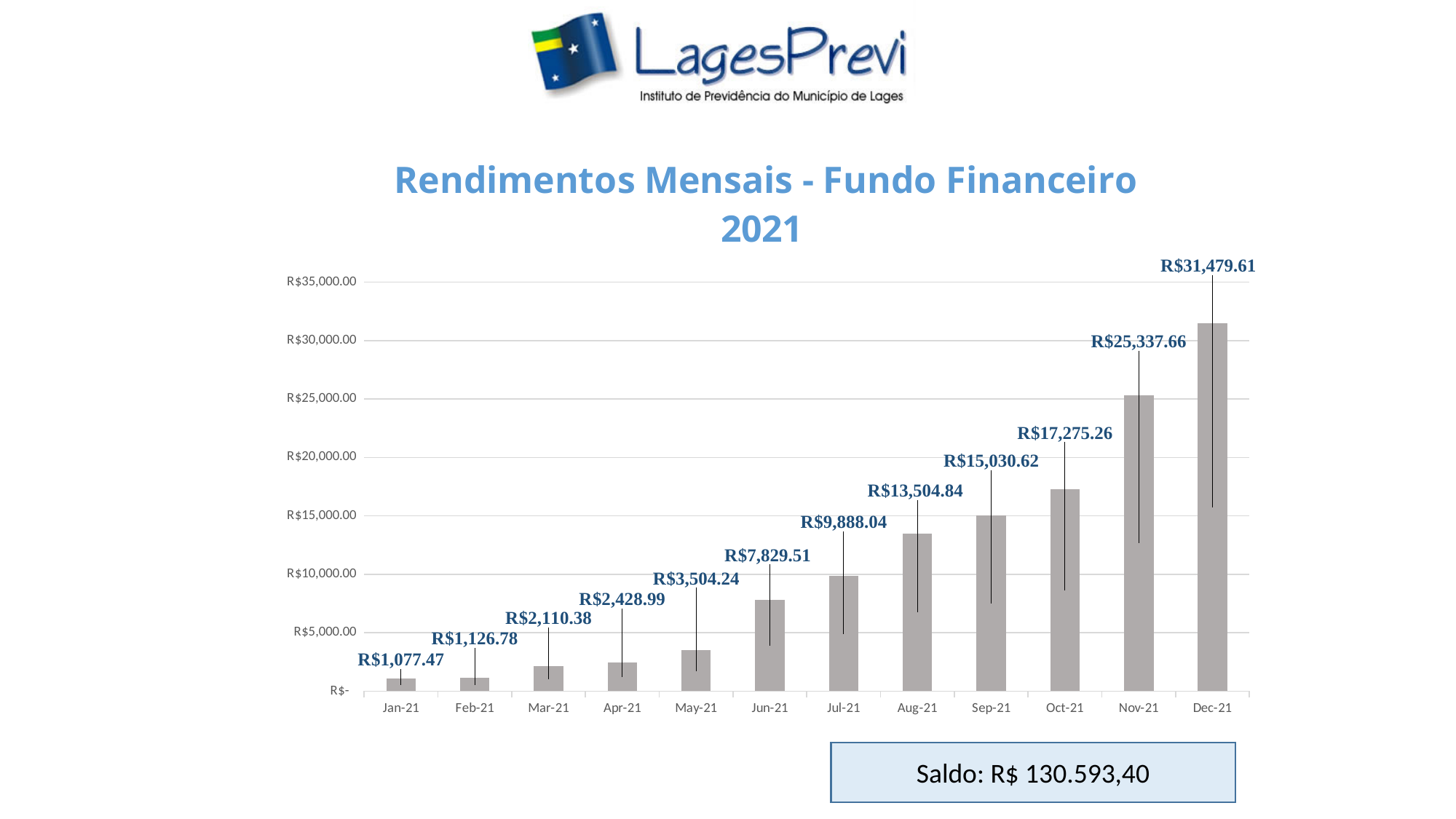
Which month has the lowest value? Jan-21 Which month has the highest value? Dec-21 What is the difference between the values for Dec-21 and Nov-21? R$6,141.95 What is the value for Jun-21? R$7,829.51 What type of chart is shown on the slide? Bar chart Is the value for Oct-21 greater or less than R$20,000.00? less What is the difference between the values for Oct-21 and Sep-21? R$2,244.64 What is the value for Mar-21? R$2,110.38 Do the values rise or fall from Jan-21 to Dec-21? Rise Which is larger, the value for Jul-21 or the value for Aug-21? Aug-21 What is the value for Sep-21? R$15,030.62 How many months are plotted on the chart? 12